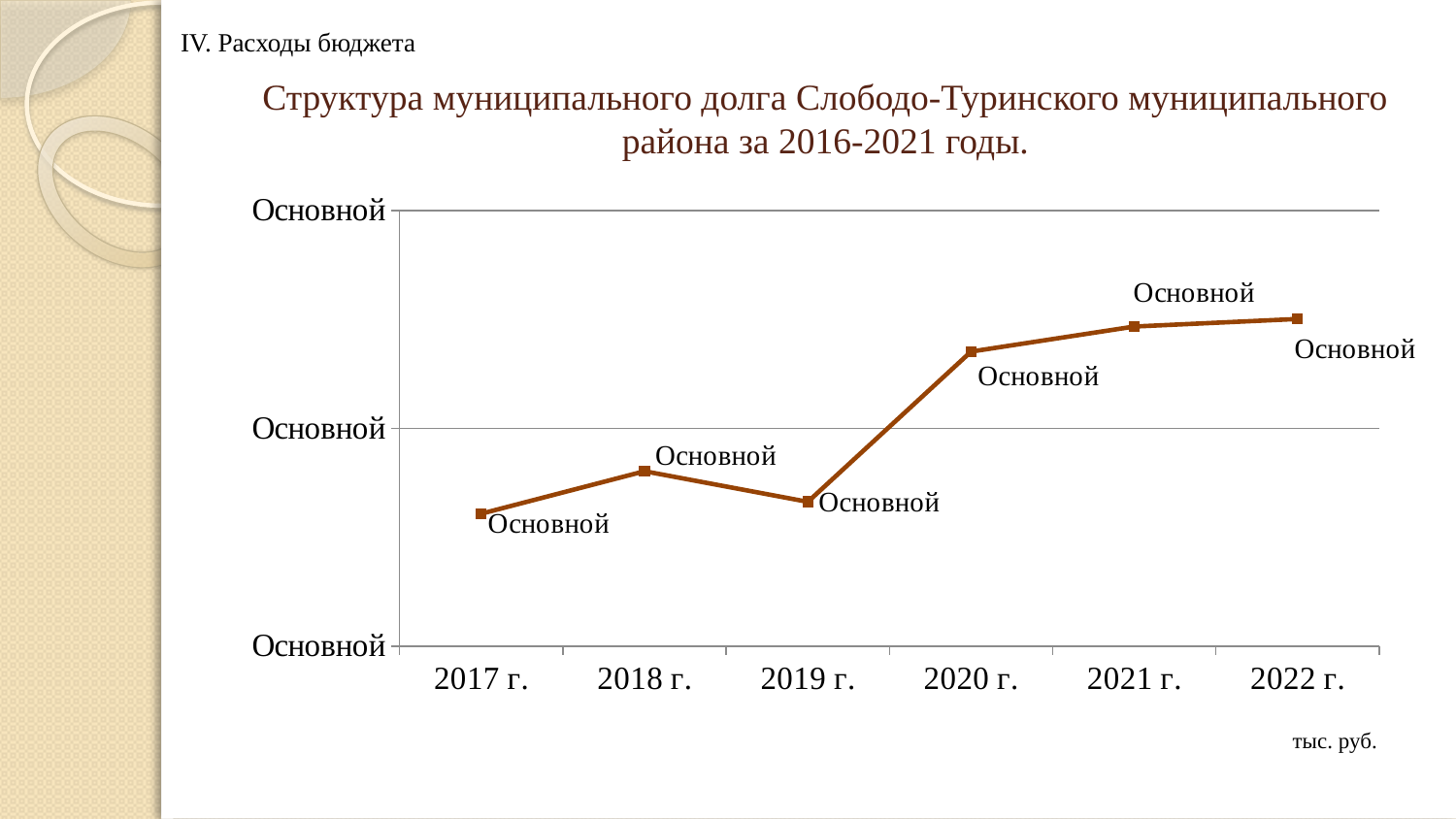
Is the value for 2018 г. larger or smaller than the value for 2019 г.? larger Which is larger, the value for 2017 г. or the value for 2021 г.? 2021 г. Which is larger, the value for 2019 г. or the value for 2020 г.? 2020 г. Overall, do the values rise or fall from 2017 г. to 2022 г.? rise Does the line rise or fall between 2018 г. and 2019 г.? fall Does the line rise or fall between 2019 г. and 2020 г.? rise What kind of chart is shown on the slide? line chart Which is the first year shown on the x axis of the chart? 2017 г. How many years (data points) are plotted on the chart? 6 What unit of measurement is indicated below the chart? тыс. руб. Which is the last year shown on the x axis of the chart? 2022 г.